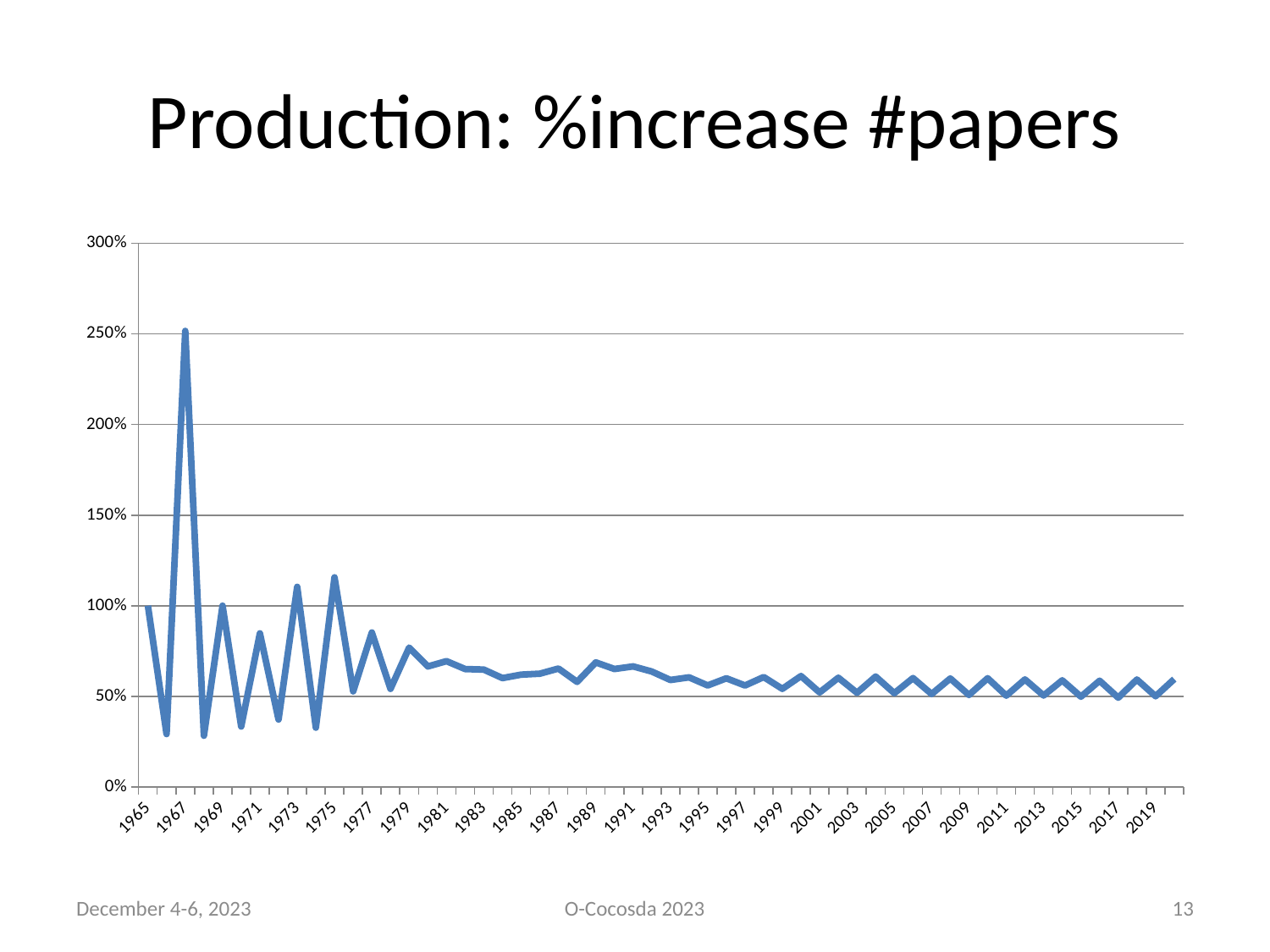
What is the title of the chart? Production: %increase #papers Is the value for 1973 greater or less than 100%? greater Is the value for 1977 greater or less than 50%? greater Is the value for 1975 greater or less than 100%? greater Which year has the highest %increase in papers? 1967 Overall, do the values rise or fall from 1965 to 2019? fall Which is larger, the value for 1967 or the value for 1975? 1967 What kind of chart is shown on the slide? line chart